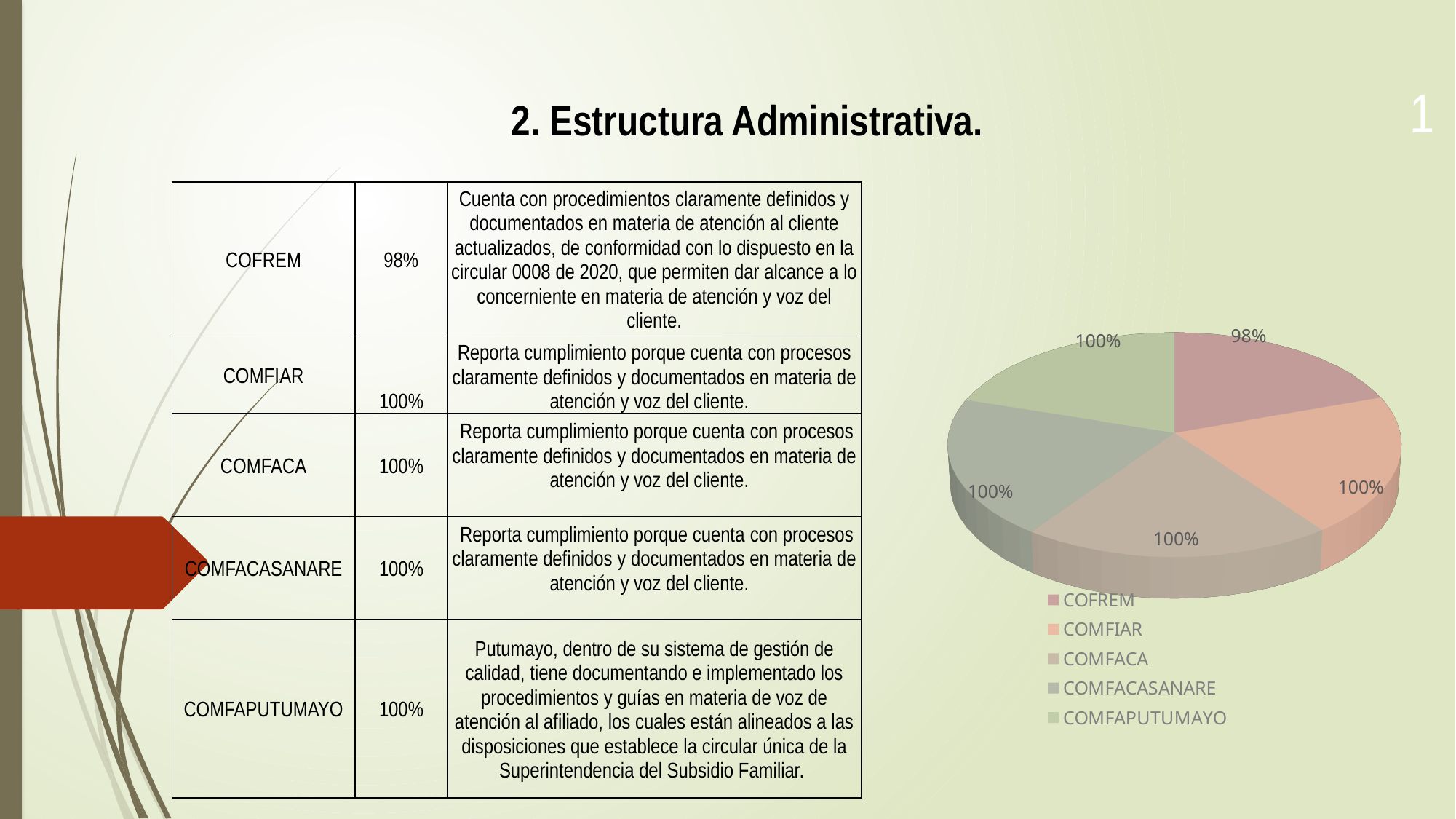
What value is shown for COFREM in the pie chart? 98% What value is shown for COMFAPUTUMAYO in the pie chart? 100% Which is larger, the value for COMFACA or the value for COFREM? COMFACA What value is shown for COMFIAR in the pie chart? 100% What kind of chart is shown on the slide? pie chart Which category has the lowest value in the pie chart? COFREM What is the difference between the value for COMFIAR and the value for COFREM? 2% What value is shown for COMFACASANARE in the pie chart? 100% How many entries does the legend of the pie chart list? 5 What value is shown for COMFACA in the pie chart? 100% How many slices does the pie chart have? 5 Which legend entry is listed first in the pie chart's legend? COFREM